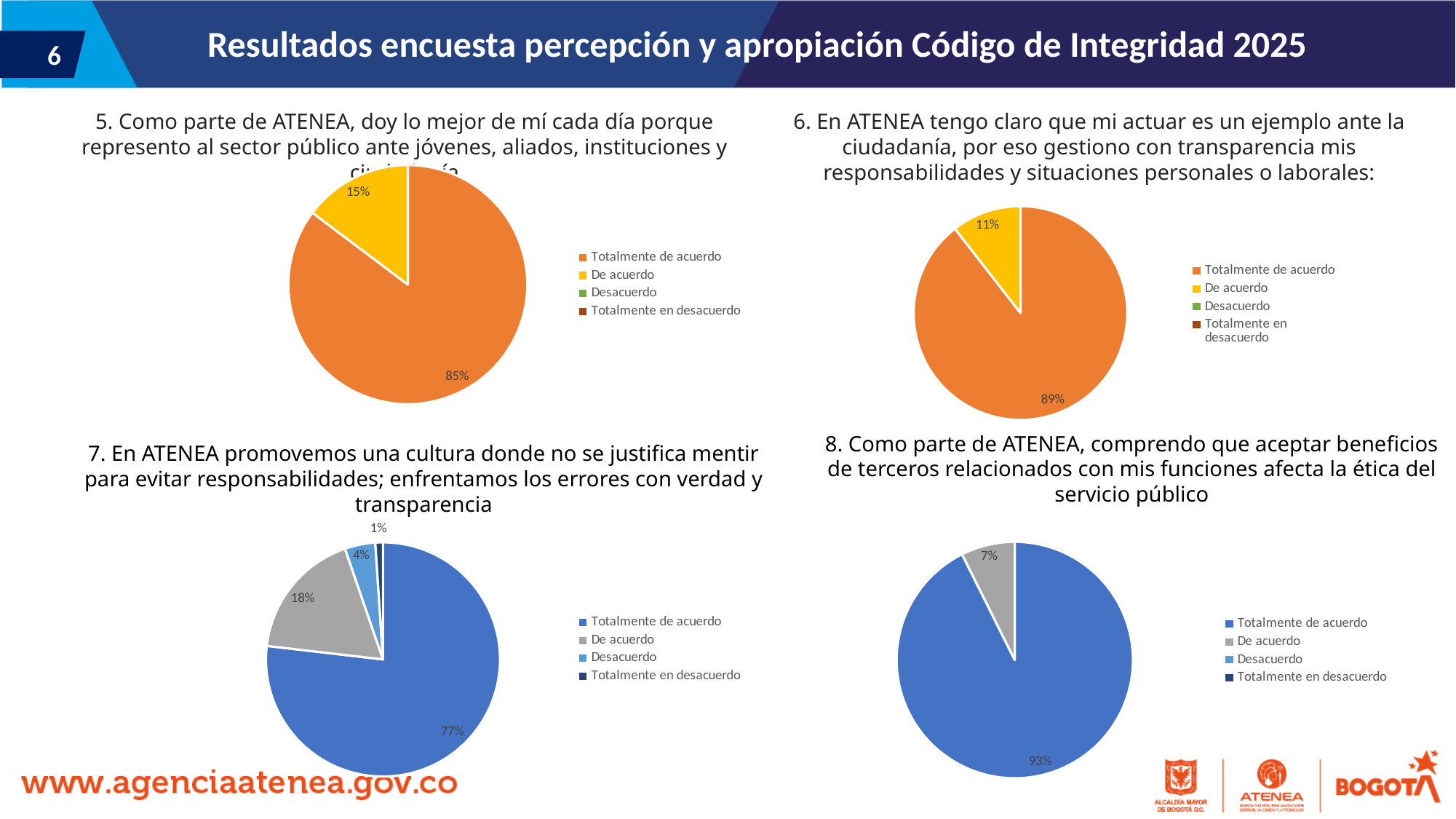
What type of chart is used for question 8 in the bottom-right of the slide? Pie chart In the bottom-right pie chart (question 8), what is the difference between the 'Totalmente de acuerdo' and 'De acuerdo' shares? 86% In the bottom-left pie chart (question 7), which category has the smallest slice? Totalmente en desacuerdo In the bottom-right pie chart (question 8), what share is labelled for 'Totalmente de acuerdo'? 93% In the top-left pie chart (question 5), what share is labelled for 'Totalmente de acuerdo'? 85% In the top-left pie chart (question 5), what share is labelled for 'De acuerdo'? 15% Which is larger in the top-left pie chart (question 5): 'Totalmente de acuerdo' or 'De acuerdo'? Totalmente de acuerdo In the top-right pie chart (question 6), what share is labelled for 'De acuerdo'? 11% In the top-right pie chart (question 6), what share is labelled for 'Totalmente de acuerdo'? 89% In the bottom-left pie chart (question 7), what share is labelled for 'De acuerdo'? 18% How many entries does the legend of the bottom-left pie chart (question 7) list? 4 In the bottom-left pie chart (question 7), what share is labelled for 'Desacuerdo'? 4%